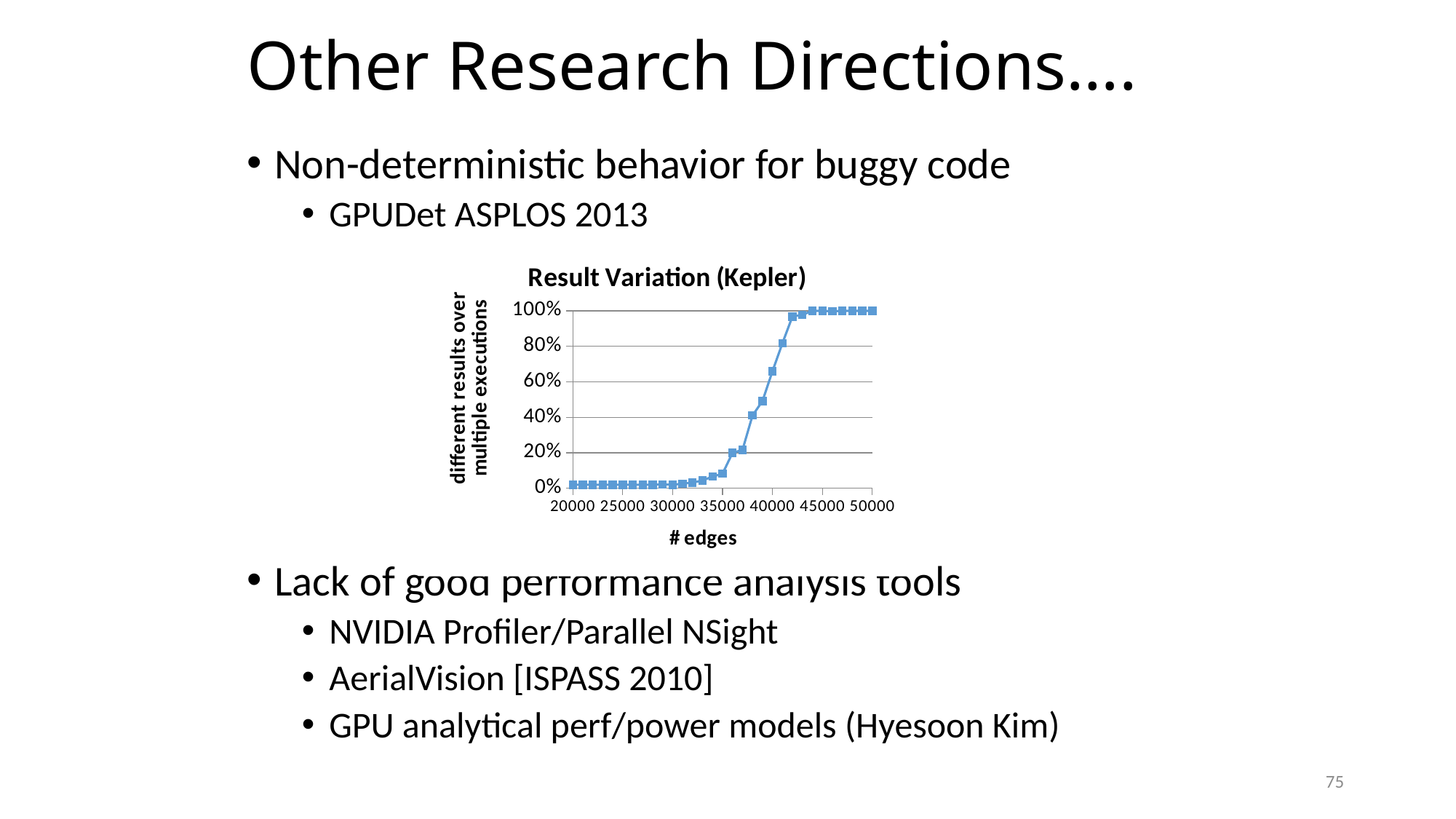
Is the value for 45000 edges greater or less than 80%? greater What is the highest value shown on the y axis of the chart? 100% Which has the larger value, 25000 edges or 40000 edges? 40000 edges What kind of chart is shown on the slide? line chart Is the value for 30000 edges greater or less than 20%? less Which has the larger value, 35000 edges or 45000 edges? 45000 edges Does the value plotted in the chart rise or fall as # edges increases from 20000 to 50000? rise What is the title of the chart on the slide? Result Variation (Kepler) What is the label of the x axis of the chart? # edges Is the value for 40000 edges greater or less than 40%? greater